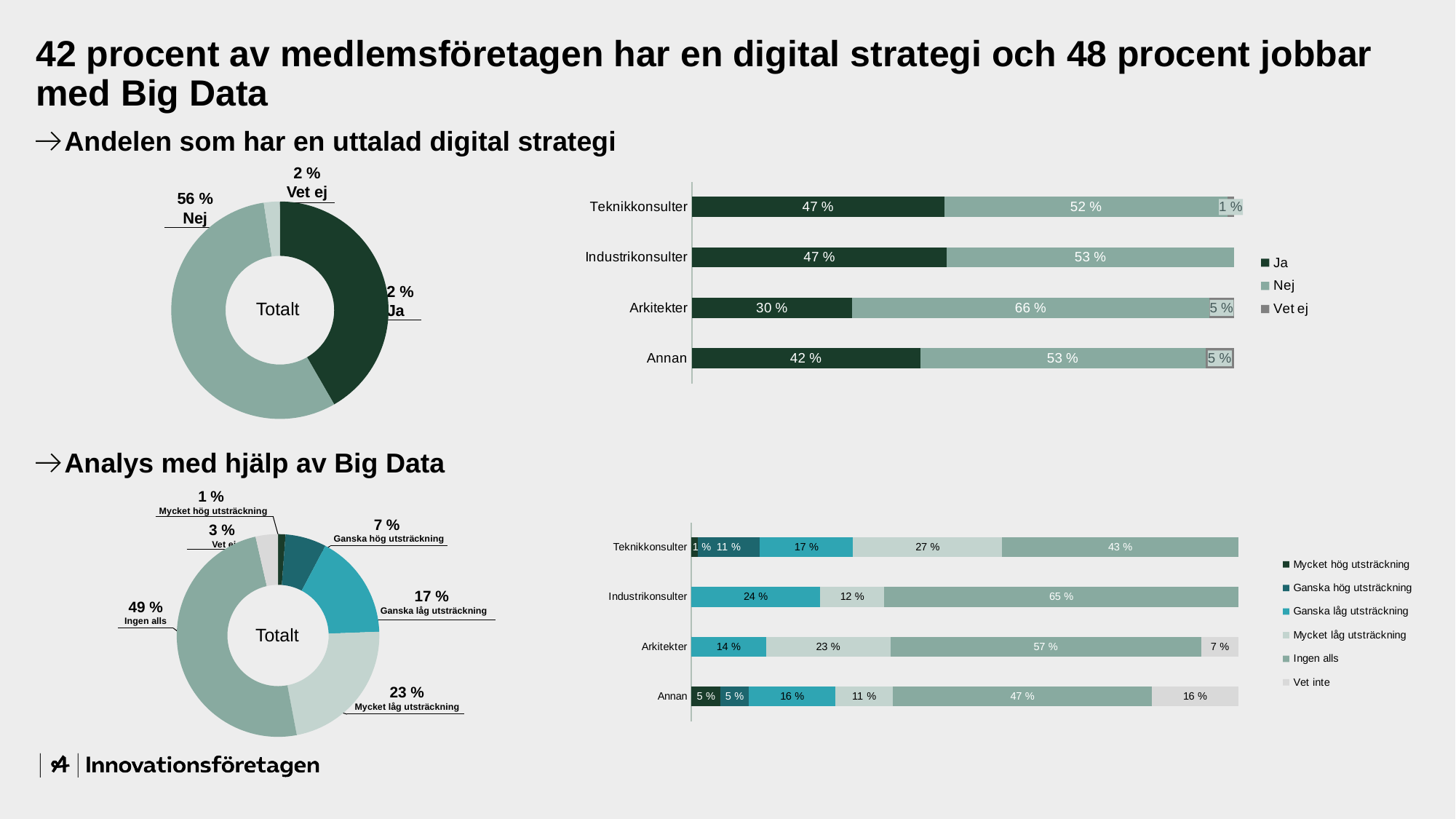
In the top-right bar chart (Andelen som har en uttalad digital strategi), what is the 'Ja' value for Arkitekter? 30 % In the top-right bar chart (Andelen som har en uttalad digital strategi), how many series does the legend list? 3 In the bottom-left donut chart (Analys med hjälp av Big Data), which category has the smallest share? Mycket hög utsträckning In the top-left donut chart (Andelen som har en uttalad digital strategi), what share of the total answered 'Vet ej'? 2 % In the bottom-left donut chart (Analys med hjälp av Big Data), what share of the total answered 'Ingen alls'? 49 % In the top-right bar chart (Andelen som har en uttalad digital strategi), which group has the highest 'Nej' value? Arkitekter In the bottom-right bar chart (Analys med hjälp av Big Data), which is larger: the 'Ganska låg utsträckning' value for Industrikonsulter or for Arkitekter? Industrikonsulter In the top-right bar chart (Andelen som har en uttalad digital strategi), what is the difference between the 'Ja' values for Teknikkonsulter and Arkitekter? 17 % In the top-left donut chart (Andelen som har en uttalad digital strategi), what share of the total answered 'Nej'? 56 % In the bottom-right bar chart (Analys med hjälp av Big Data), what is the 'Ingen alls' value for Industrikonsulter? 65 % In the top-right bar chart (Andelen som har en uttalad digital strategi), what is the 'Nej' value for Industrikonsulter? 53 % In the bottom-right bar chart (Analys med hjälp av Big Data), how many series does the legend list? 6